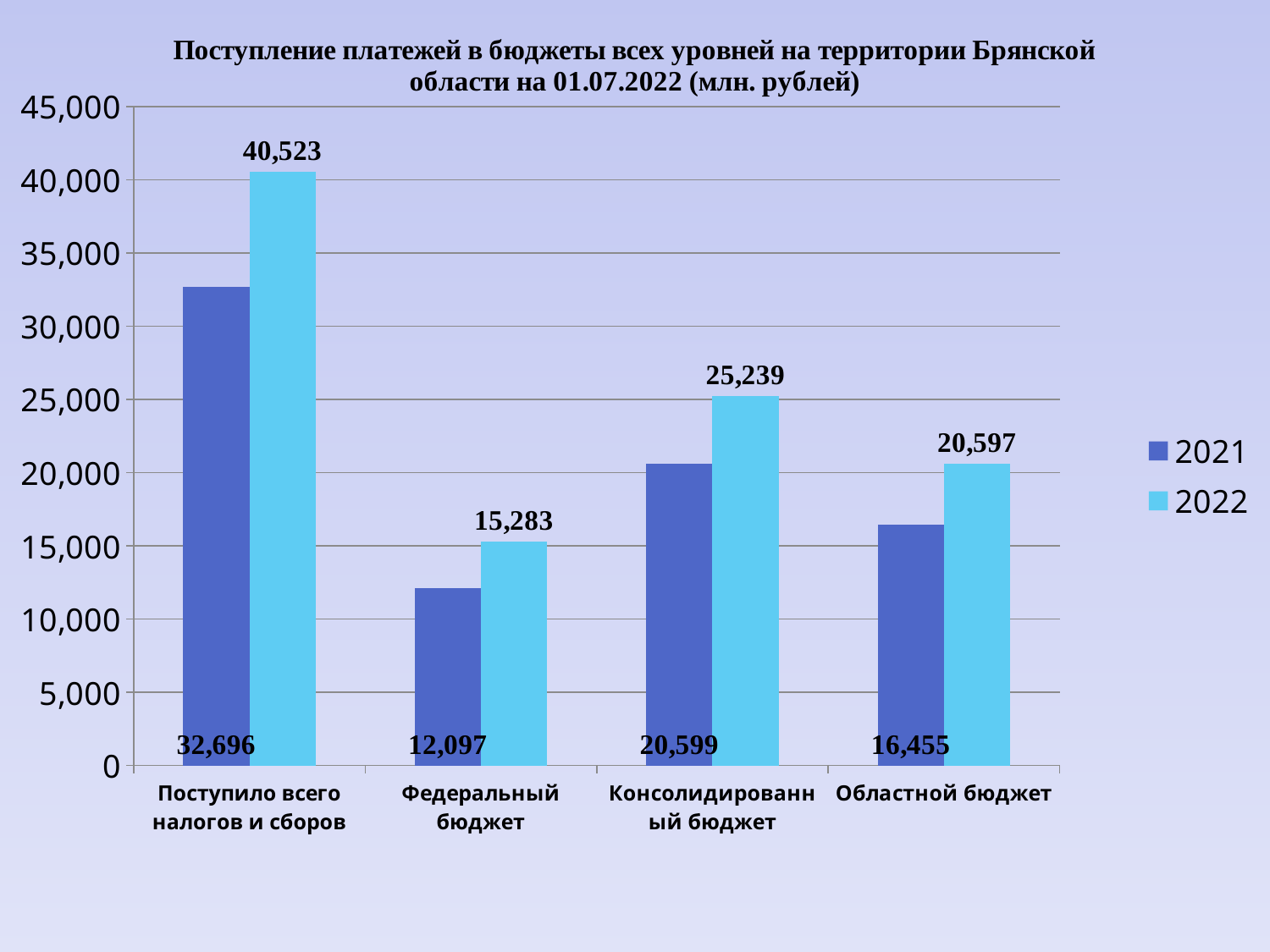
What kind of chart is shown on the slide? bar chart How many series does the legend list? 2 What is the 2021 value for Областной бюджет? 16,455 What is the difference between the 2022 and 2021 values for Поступило всего налогов и сборов? 7,827 What is the 2021 value for Федеральный бюджет? 12,097 Which category has the highest 2021 value? Поступило всего налогов и сборов Which series is shown in light blue in the legend? 2022 Which is larger for Областной бюджет, the 2021 value or the 2022 value? 2022 What is the 2022 value for Консолидированный бюджет? 25,239 How many categories are shown on the x axis? 4 What is the 2022 value for Поступило всего налогов и сборов? 40,523 Which category has the lowest 2022 value? Федеральный бюджет